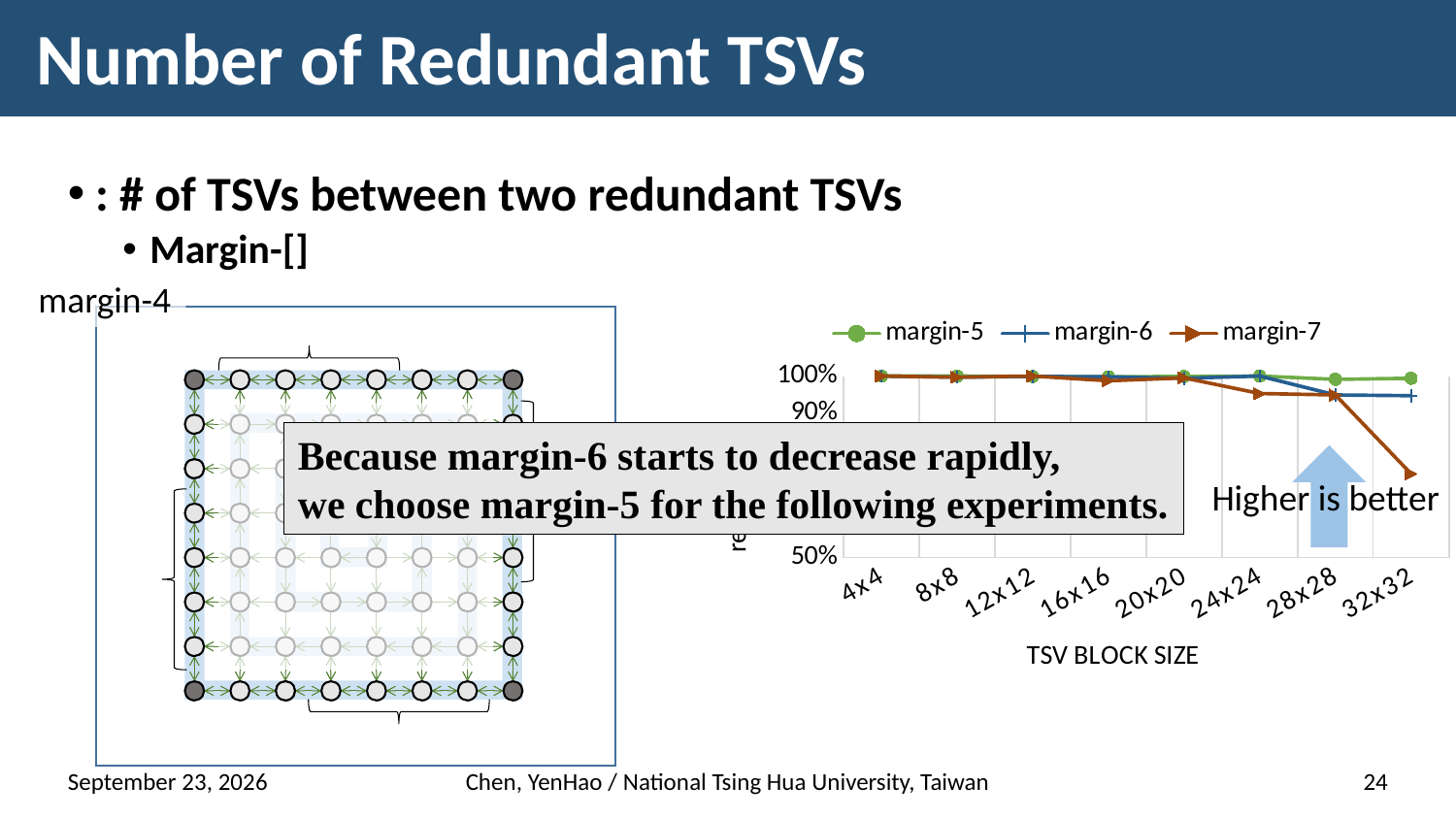
In the line chart, is the value for margin-5 at 32x32 greater or less than 90%? greater What are the series names listed in the legend of the line chart? margin-5, margin-6, margin-7 In the line chart, which series has the highest value at 32x32? margin-5 In the line chart, which series has the lowest value at 32x32? margin-7 What is the highest tick value shown on the y axis of the line chart? 100% How many TSV block sizes are shown along the x axis of the line chart? 8 How many series does the legend of the line chart list? 3 In the line chart, does the margin-7 series rise or fall as the TSV block size increases from 24x24 to 32x32? fall In the line chart, which is larger at 32x32: margin-6 or margin-7? margin-6 What kind of chart is shown on the right side of the slide? line chart What is the title of the x axis of the line chart? TSV BLOCK SIZE In the line chart, is the value for margin-7 at 32x32 greater or less than 90%? less